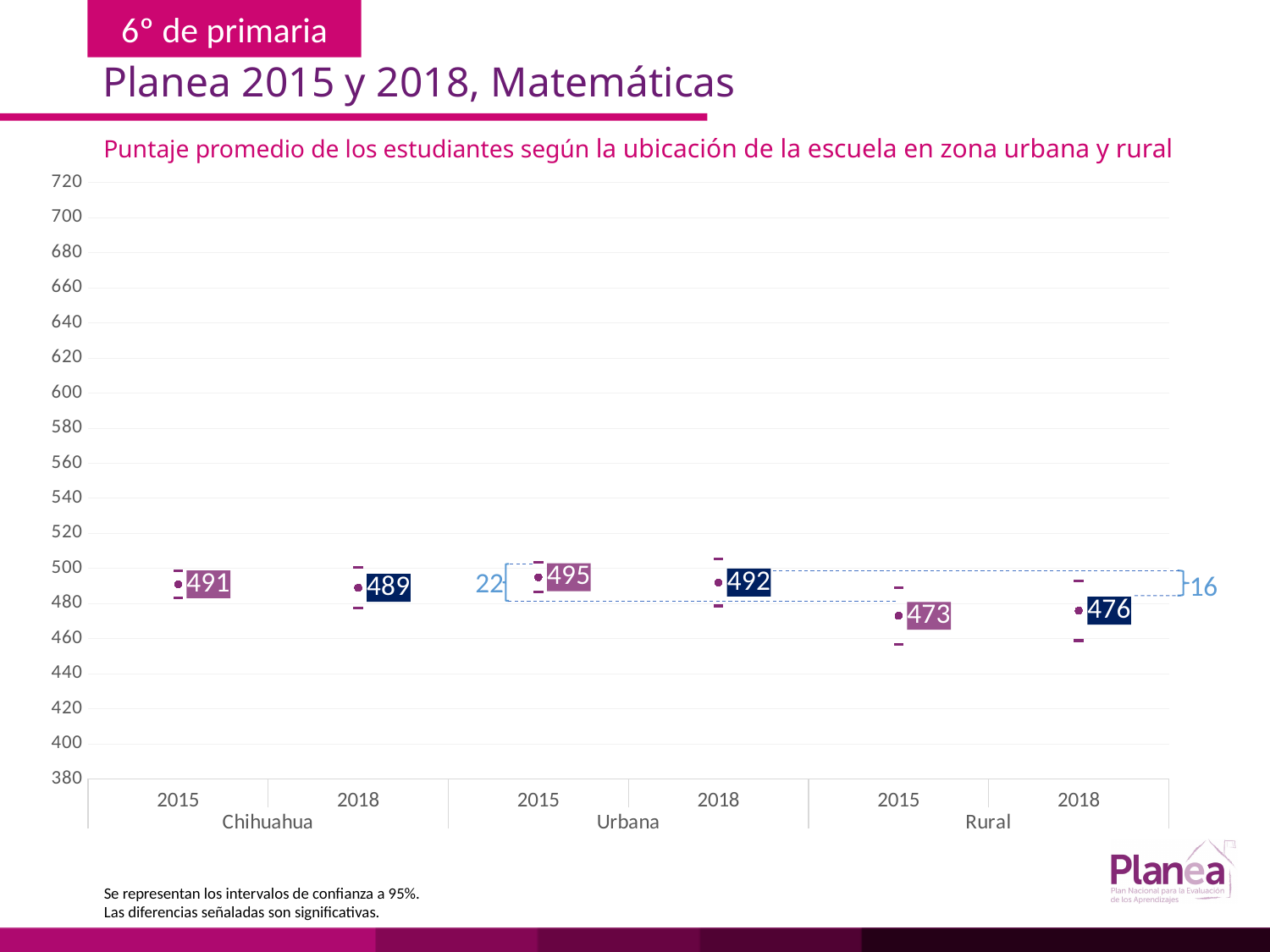
Which group and year has the lowest average score? Rural 2015 How many data points are plotted on the chart? 6 What is the average score for Chihuahua in 2018? 489 What is the average score for Rural schools in 2018? 476 What is the title of the chart? Puntaje promedio de los estudiantes según la ubicación de la escuela en zona urbana y rural What is the difference between the Urbana and Rural average scores in 2018? 16 What is the difference between the Urbana and Rural average scores in 2015? 22 What is the average score for Urbana schools in 2015? 495 What is the average score for Chihuahua in 2015? 491 Which is larger, the Rural score in 2015 or the Rural score in 2018? Rural 2018 Which group and year has the highest average score? Urbana 2015 Is the Rural 2015 average score greater or less than 480? less